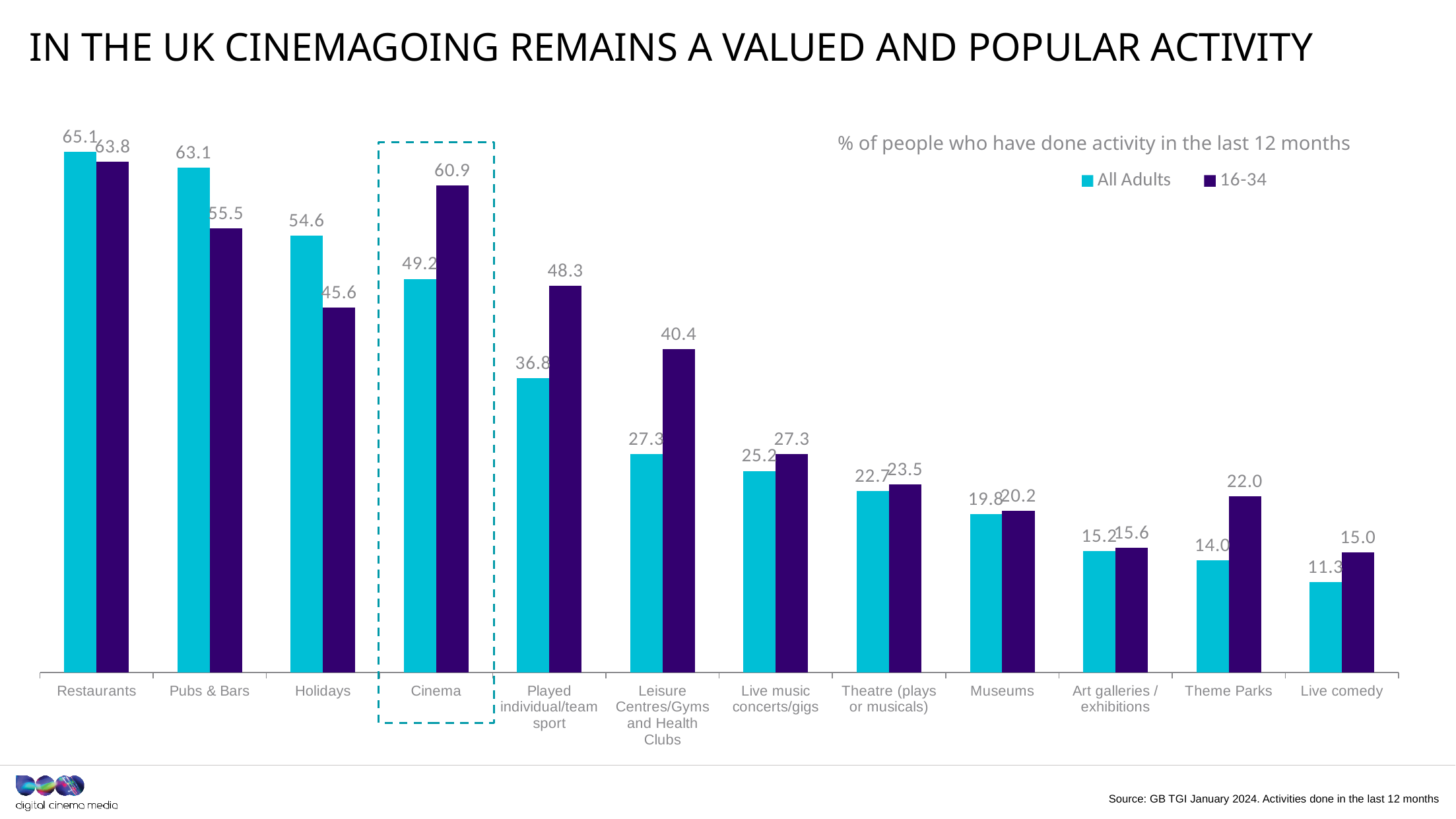
Which category has the lowest value in the All Adults series? Live comedy What kind of chart is shown on the slide? Bar chart Which category has the highest value in the All Adults series? Restaurants What is the value for Cinema in the 16-34 series? 60.9 How many series does the legend list? 2 Which is larger for Holidays: the All Adults value or the 16-34 value? All Adults How many activity categories are shown on the chart? 12 What is the difference between the 16-34 and All Adults values for Cinema? 11.7 What is the value for Cinema in the All Adults series? 49.2 Which is larger for Played individual/team sport: the All Adults value or the 16-34 value? 16-34 What is the value for Holidays in the 16-34 series? 45.6 What is the difference between the All Adults and 16-34 values for Pubs & Bars? 7.6